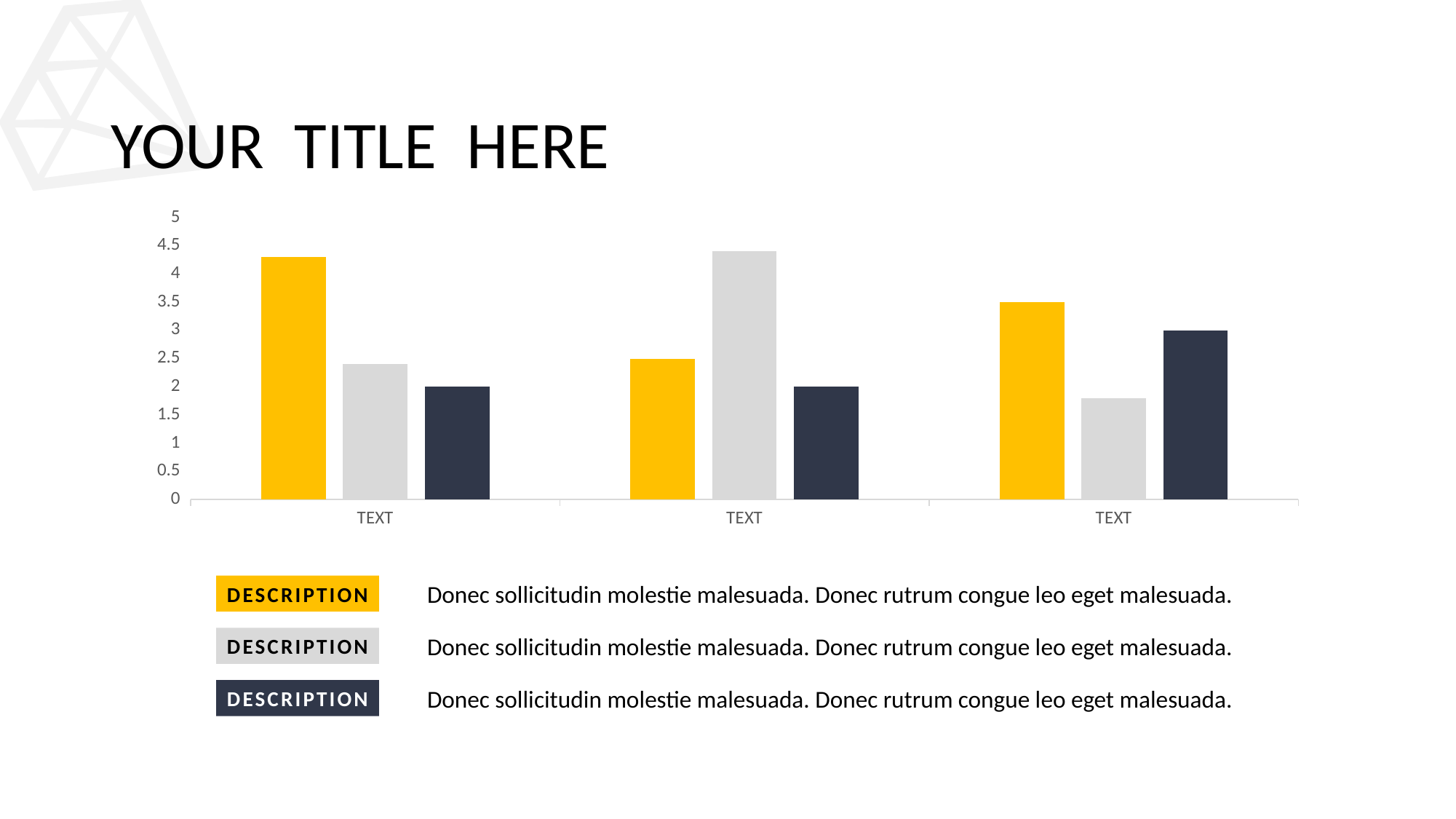
What is the highest value shown on the vertical axis? 5 Is the yellow bar in the second (middle) group greater or less than 3? less What kind of chart is shown on the slide? bar chart In the third (rightmost) group, which is larger: the yellow bar or the dark navy bar? yellow Which colour bar is the tallest in the first (leftmost) group? yellow Is the grey bar in the second (middle) group greater or less than 4? greater Which colour bar is the shortest in the third (rightmost) group? grey Is the grey bar in the third (rightmost) group greater or less than 2? less How many bars are there in each category group? 3 Which colour bar is the tallest in the second (middle) group? grey How many category groups are shown along the x axis? 3